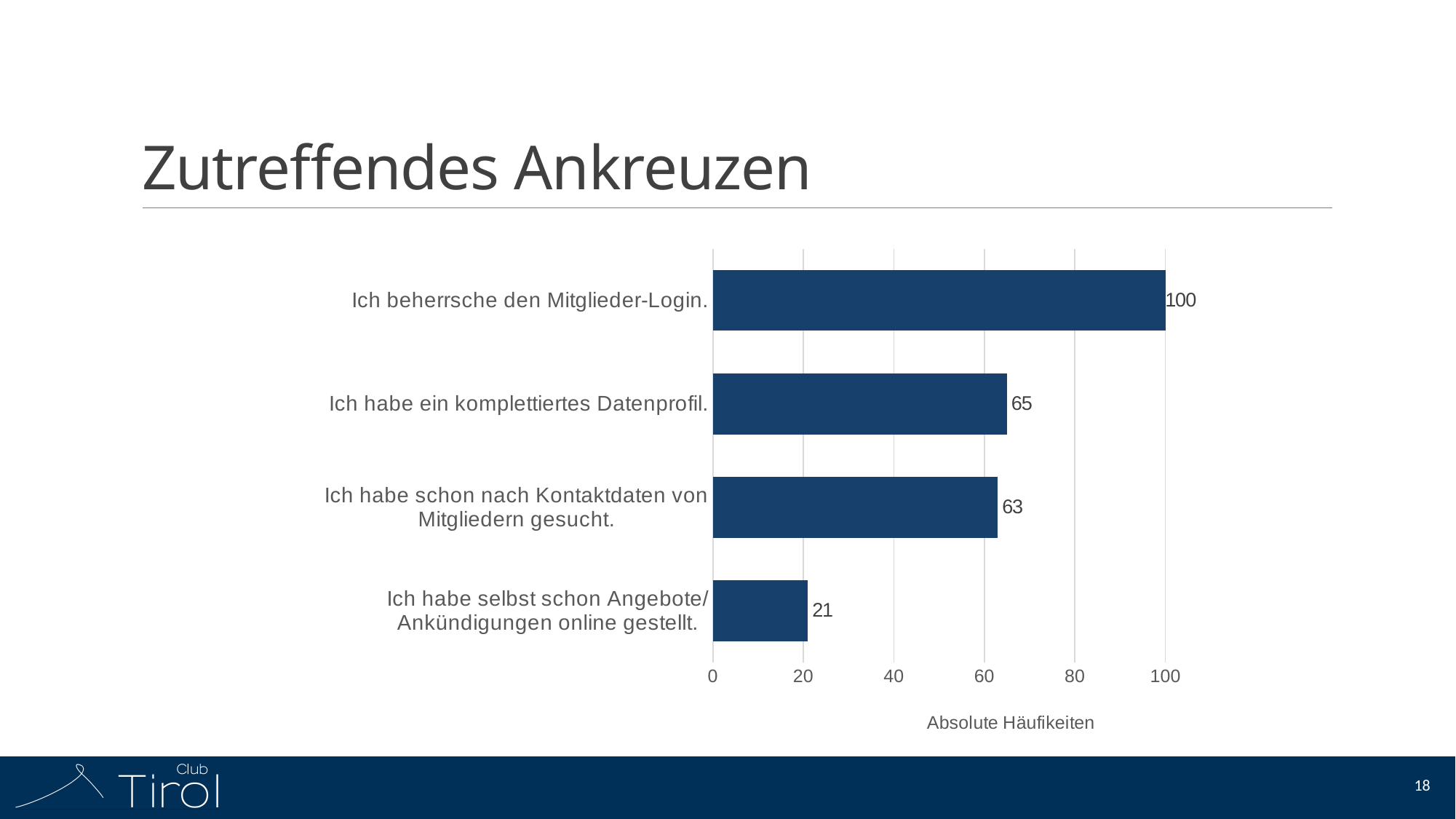
What is the value for "Ich beherrsche den Mitglieder-Login."? 100 Which category has the highest value? Ich beherrsche den Mitglieder-Login. What kind of chart is shown on the slide? Bar chart Which category has the lowest value? Ich habe selbst schon Angebote/ Ankündigungen online gestellt. What is the value for "Ich habe selbst schon Angebote/ Ankündigungen online gestellt."? 21 How many categories are shown in the chart? 4 What is the label of the horizontal axis? Absolute Häufikeiten What is the difference between the values for "Ich beherrsche den Mitglieder-Login." and "Ich habe ein komplettiertes Datenprofil."? 35 What is the value for "Ich habe ein komplettiertes Datenprofil."? 65 Which is larger: the value for "Ich habe ein komplettiertes Datenprofil." or for "Ich habe selbst schon Angebote/ Ankündigungen online gestellt."? Ich habe ein komplettiertes Datenprofil. What is the value for "Ich habe schon nach Kontaktdaten von Mitgliedern gesucht."? 63 What is the difference between the values for "Ich habe schon nach Kontaktdaten von Mitgliedern gesucht." and "Ich habe selbst schon Angebote/ Ankündigungen online gestellt."? 42